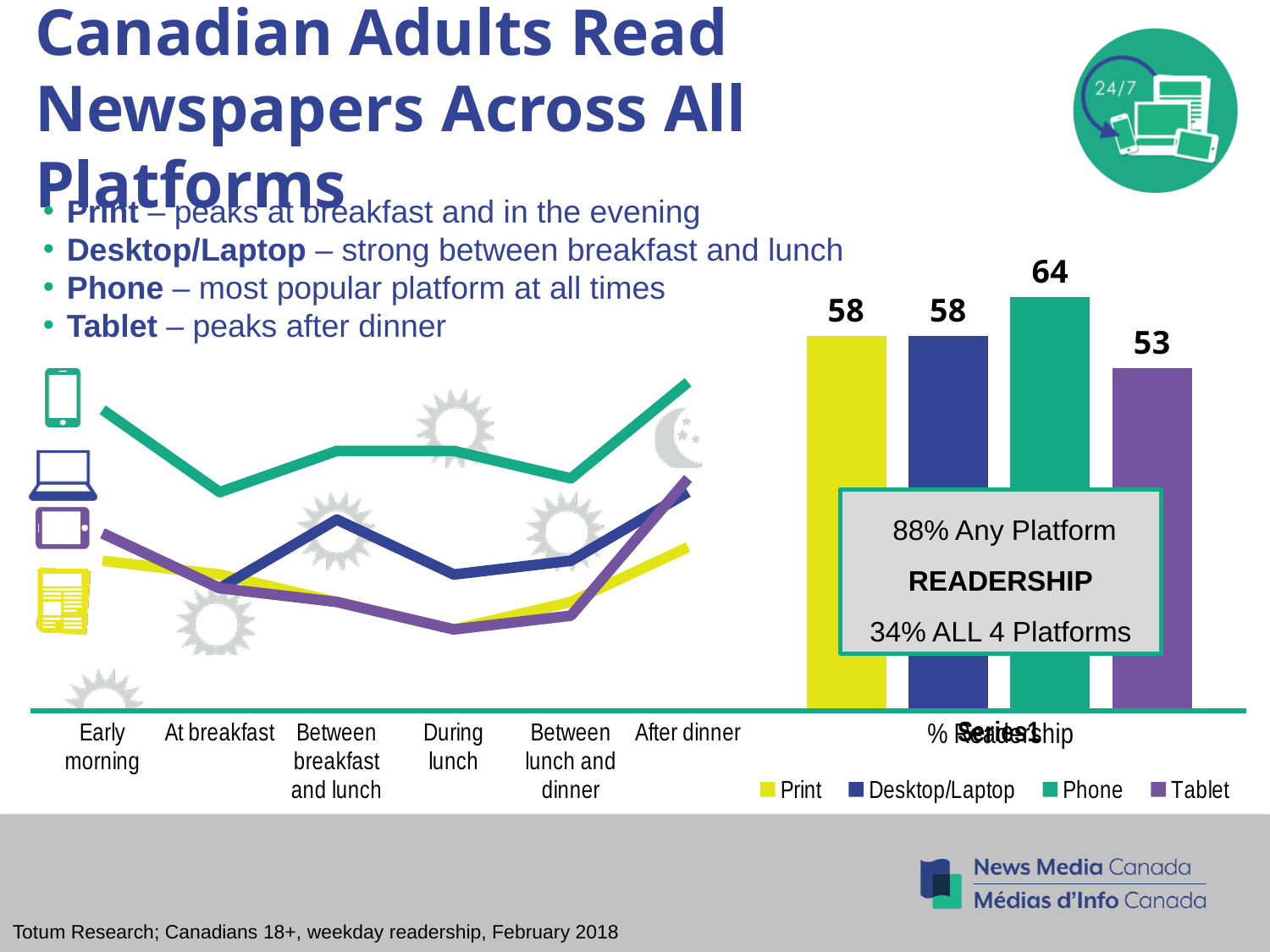
In the bar chart on the right, what is the % Readership value for Phone? 64 In the bar chart on the right, which is larger, the value for Desktop/Laptop or the value for Tablet? Desktop/Laptop In the line chart on the left, which platform has the highest line at After dinner? Phone How many bars are shown in the bar chart on the right? 4 In the bar chart on the right, which platform has the highest % Readership? Phone In the bar chart on the right, what is the difference between the Phone value and the Tablet value? 11 What kind of chart is the chart on the left showing readership by time of day? Line chart How many series does the legend at the bottom right list? 4 How many time-of-day categories are shown on the x axis of the line chart on the left? 6 In the bar chart on the right, what is the % Readership value for Tablet? 53 In the bar chart on the right, which platform has the lowest % Readership? Tablet In the bar chart on the right, what is the % Readership value for Print? 58